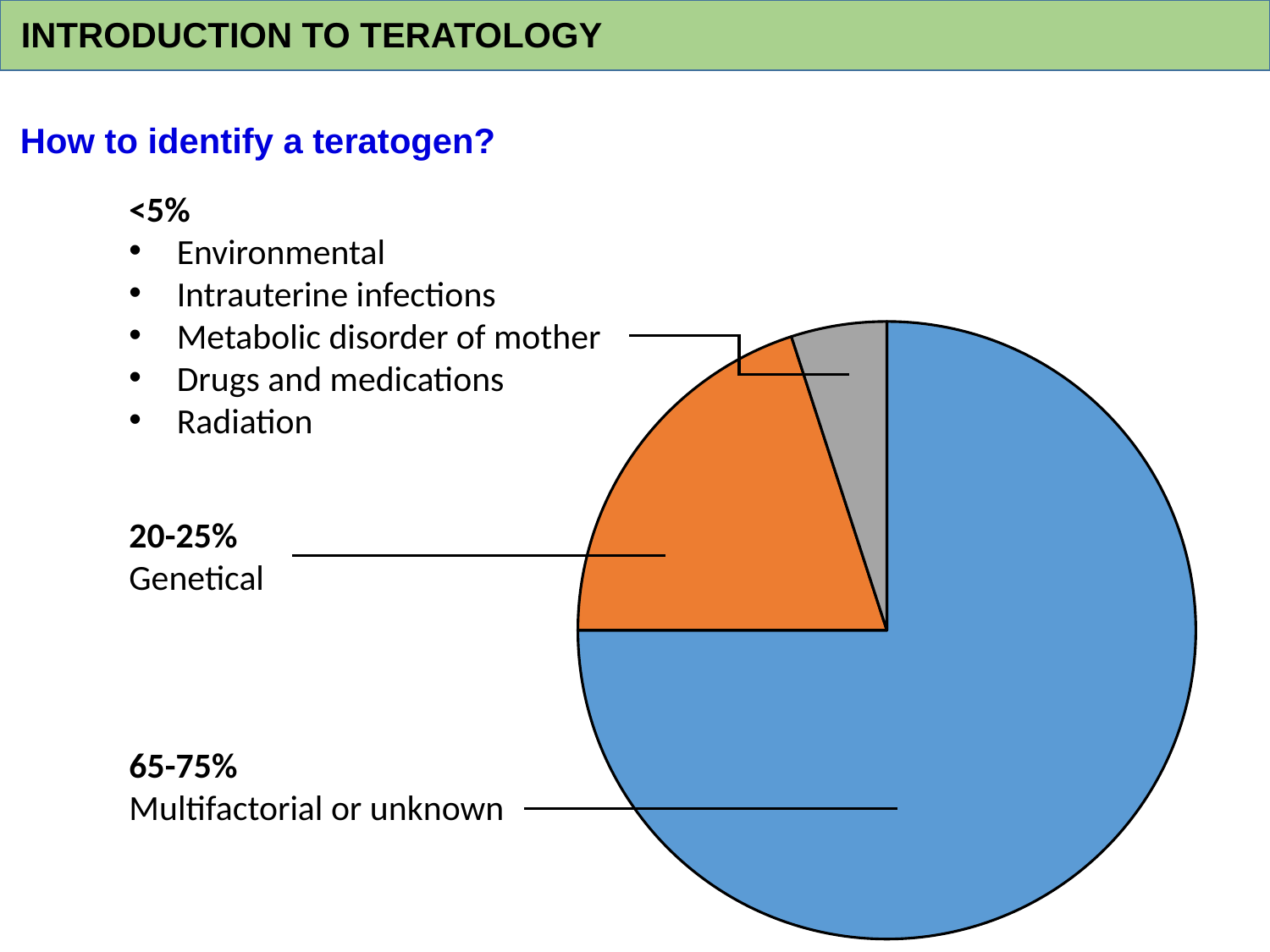
Which slice of the pie chart is the largest? Multifactorial or unknown Which slice is larger, Genetical or Multifactorial or unknown? Multifactorial or unknown What share is labelled for the Multifactorial or unknown slice? 65-75% What share is labelled for the slice covering Environmental, Intrauterine infections, Metabolic disorder of mother, Drugs and medications and Radiation? <5% Is the Multifactorial or unknown slice greater or less than 50% of the pie? greater What colour is the Multifactorial or unknown slice of the pie chart? blue What kind of chart is shown on the slide? pie chart Which slice is larger, Genetical or the <5% slice? Genetical What colour is the Genetical slice of the pie chart? orange Which slice of the pie chart is the smallest? the <5% slice (Environmental, Intrauterine infections, Metabolic disorder of mother, Drugs and medications, Radiation) What share is labelled for the Genetical slice? 20-25% How many slices does the pie chart have? 3